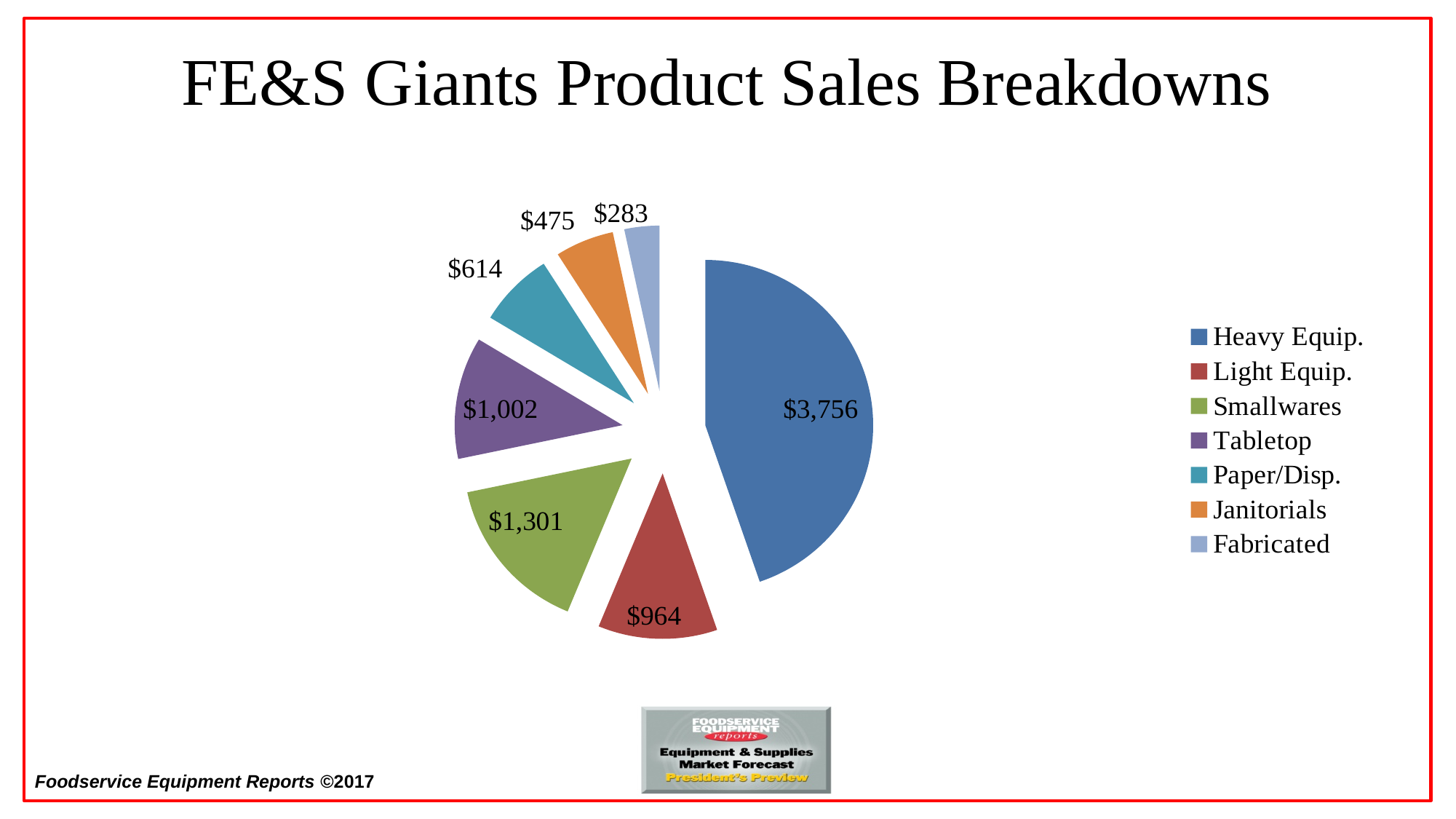
What is the total of all slices in the pie chart? $8,395 Which category has the largest slice of the pie? Heavy Equip. What is the value for Fabricated? $283 Which category has the smallest slice of the pie? Fabricated What is the value for Heavy Equip. in the pie chart? $3,756 What is the title of the chart on the slide? FE&S Giants Product Sales Breakdowns How many categories does the pie chart show? 7 What is the value for Smallwares? $1,301 What is the difference between the Heavy Equip. and Light Equip. values? $2,792 What is the value for Paper/Disp.? $614 What type of chart is shown on the slide? Pie chart Which is larger, Tabletop or Light Equip.? Tabletop